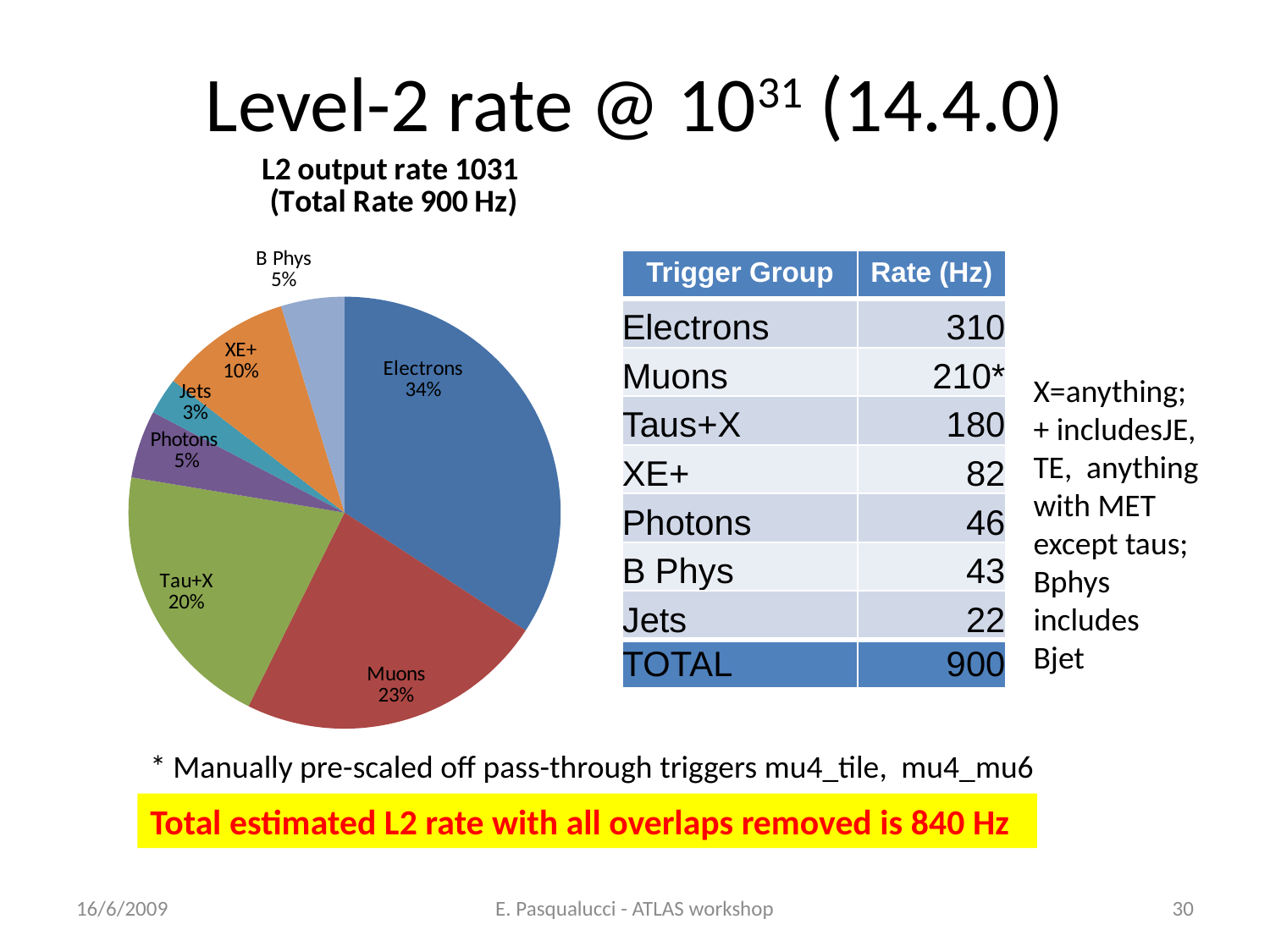
What share of the pie does Electrons have? 34% Which slice of the pie chart is the largest? Electrons What kind of chart is shown on the slide? pie chart What share of the pie does Tau+X have? 20% What is the title of the pie chart? L2 output rate 1031 (Total Rate 900 Hz) How many slices does the pie chart have? 7 What share of the pie does Jets have? 3% Which slice of the pie chart is the smallest? Jets What is the difference in percentage points between the Electrons slice and the Muons slice? 11 Which slice is larger, Tau+X or XE+? Tau+X